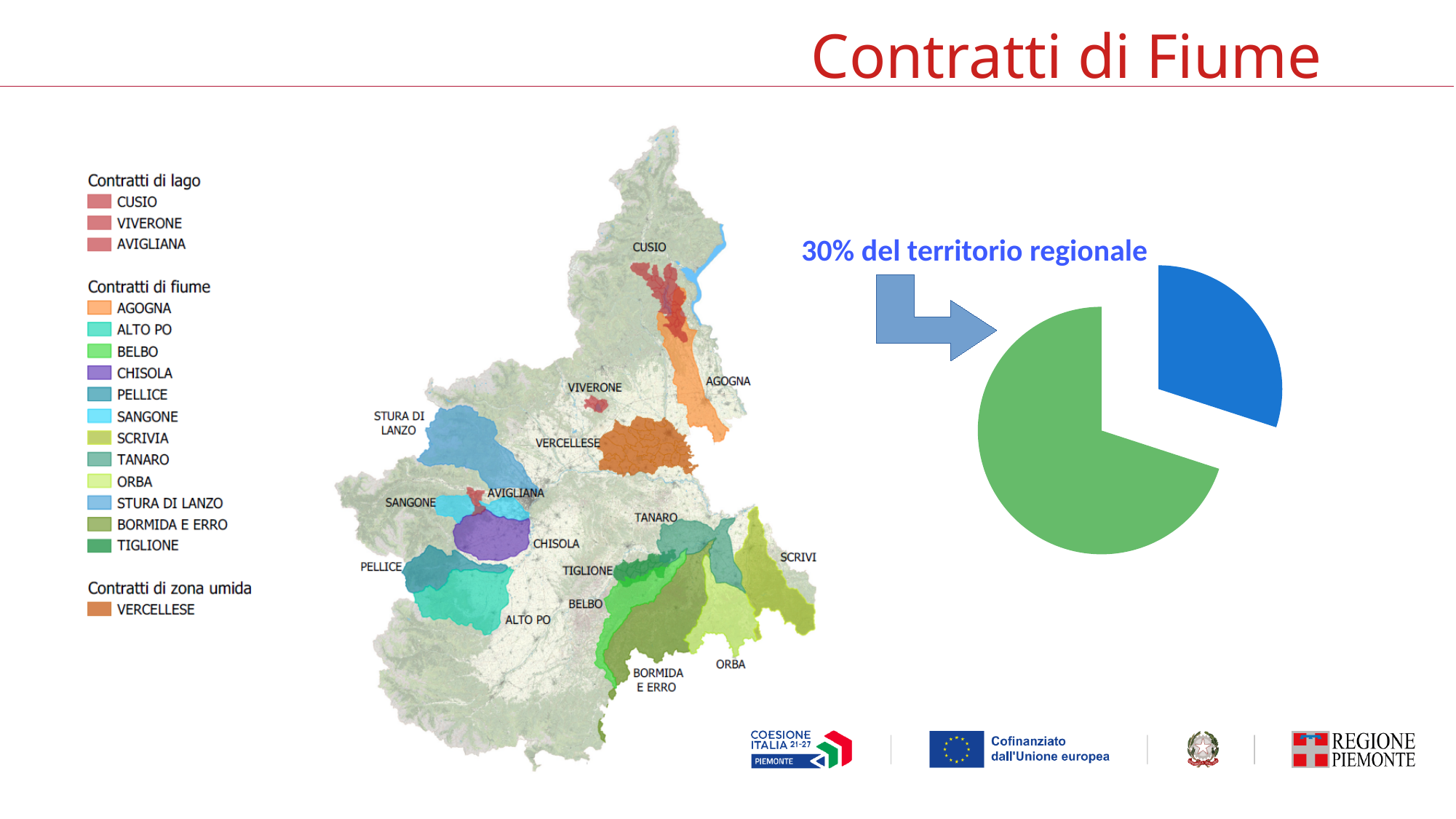
Which slice of the pie chart is larger, the green one or the blue one? green What share of the regional territory does the blue slice of the pie chart represent, according to the label above it? 30% What text is written above the pie chart, next to the arrow? 30% del territorio regionale How many slices does the pie chart have? 2 Is the blue slice of the pie chart greater or less than 50% of the pie? less What kind of chart is shown on the right side of the slide? pie chart Is the green slice of the pie chart greater or less than 50% of the pie? greater What colour is the slice that is pulled out (exploded) from the pie chart? blue